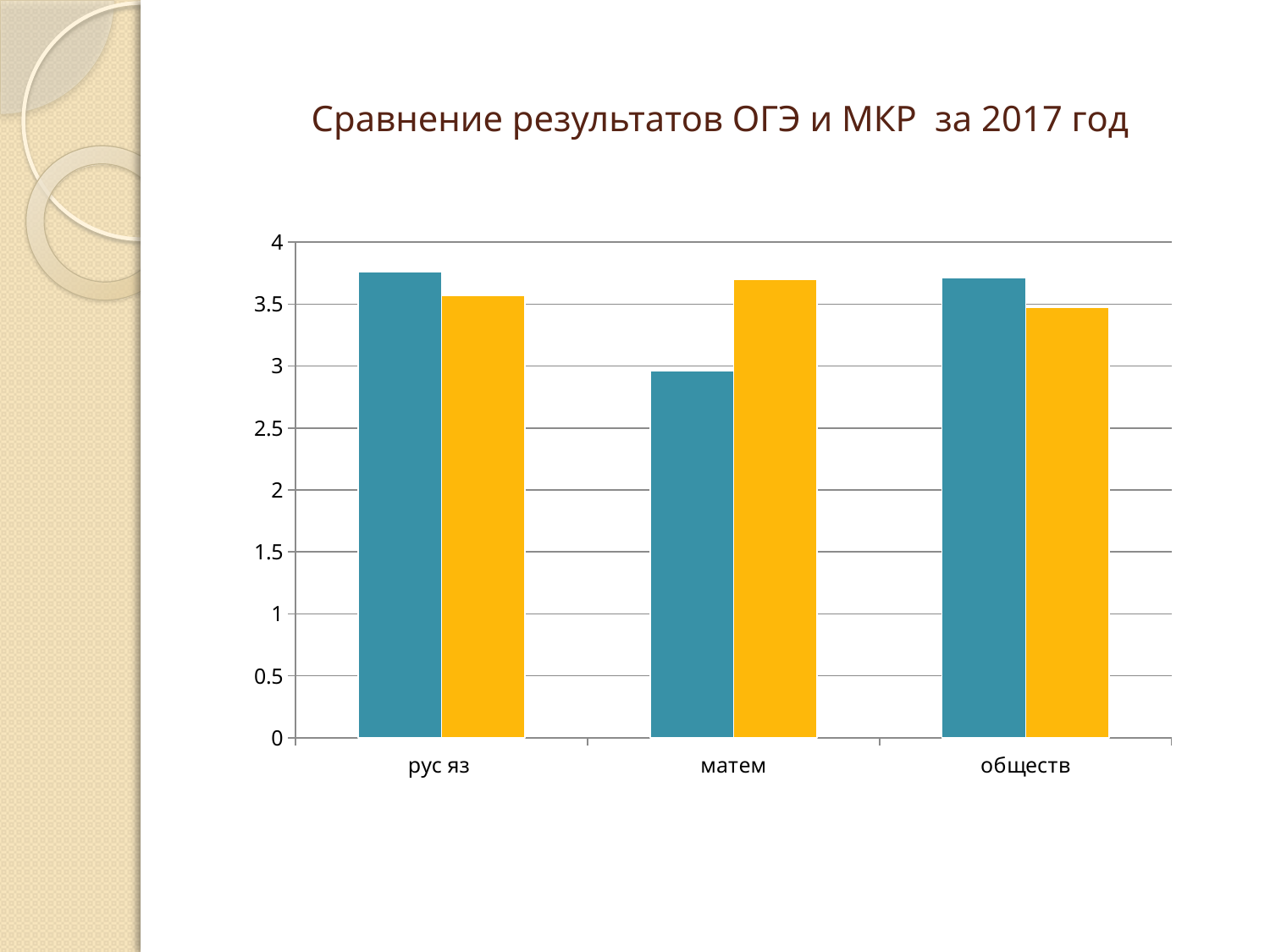
For рус яз, which bar is taller, the blue one or the orange one? the blue one What is the title of the chart slide? Сравнение результатов ОГЭ и МКР за 2017 год Is the value of the blue bar for матем greater or less than 2.5? greater Is the value of the blue bar for рус яз greater or less than 3.5? greater Is the value of the orange bar for матем greater or less than 3.5? greater How many categories are shown on the x axis of the chart? 3 How many bars are shown for each category in the chart? 2 Which category has the highest orange bar? матем What kind of chart is shown on the slide? bar chart For матем, which bar is taller, the blue one or the orange one? the orange one Which category has the lowest blue bar? матем